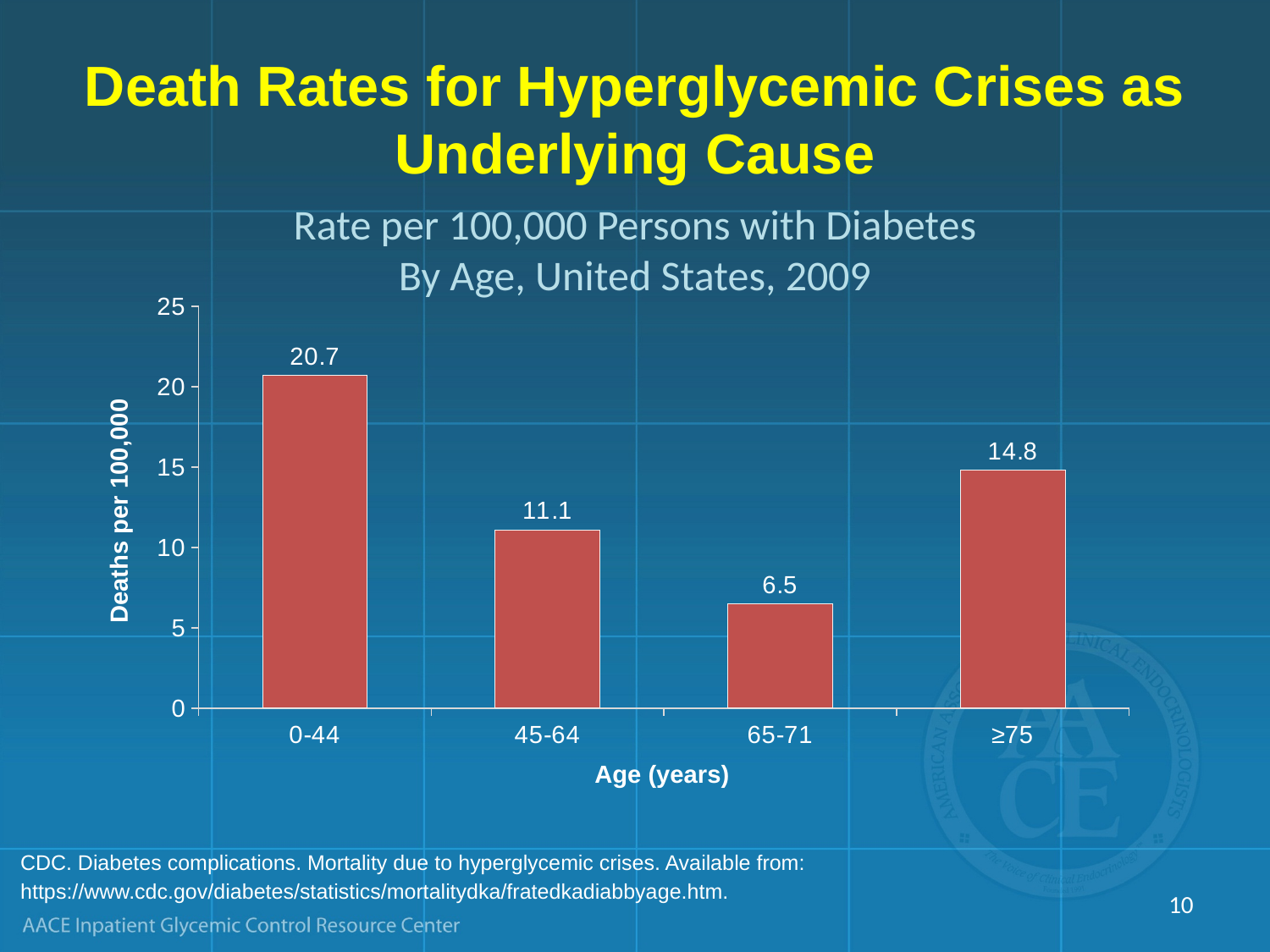
What is the label of the y axis? Deaths per 100,000 What is the death rate per 100,000 for the 65-71 age group? 6.5 What is the difference between the death rates for the 0-44 and 65-71 age groups? 14.2 What is the death rate per 100,000 for the ≥75 age group? 14.8 Which age group has a higher death rate, 45-64 or ≥75? ≥75 Which age group has the highest death rate? 0-44 What is the death rate per 100,000 for the 45-64 age group? 11.1 What kind of chart is shown on the slide? Bar chart What is the death rate per 100,000 for the 0-44 age group? 20.7 How many age groups are shown on the chart? 4 Which age group has the lowest death rate? 65-71 Is the value for the 45-64 age group greater or less than 10? greater